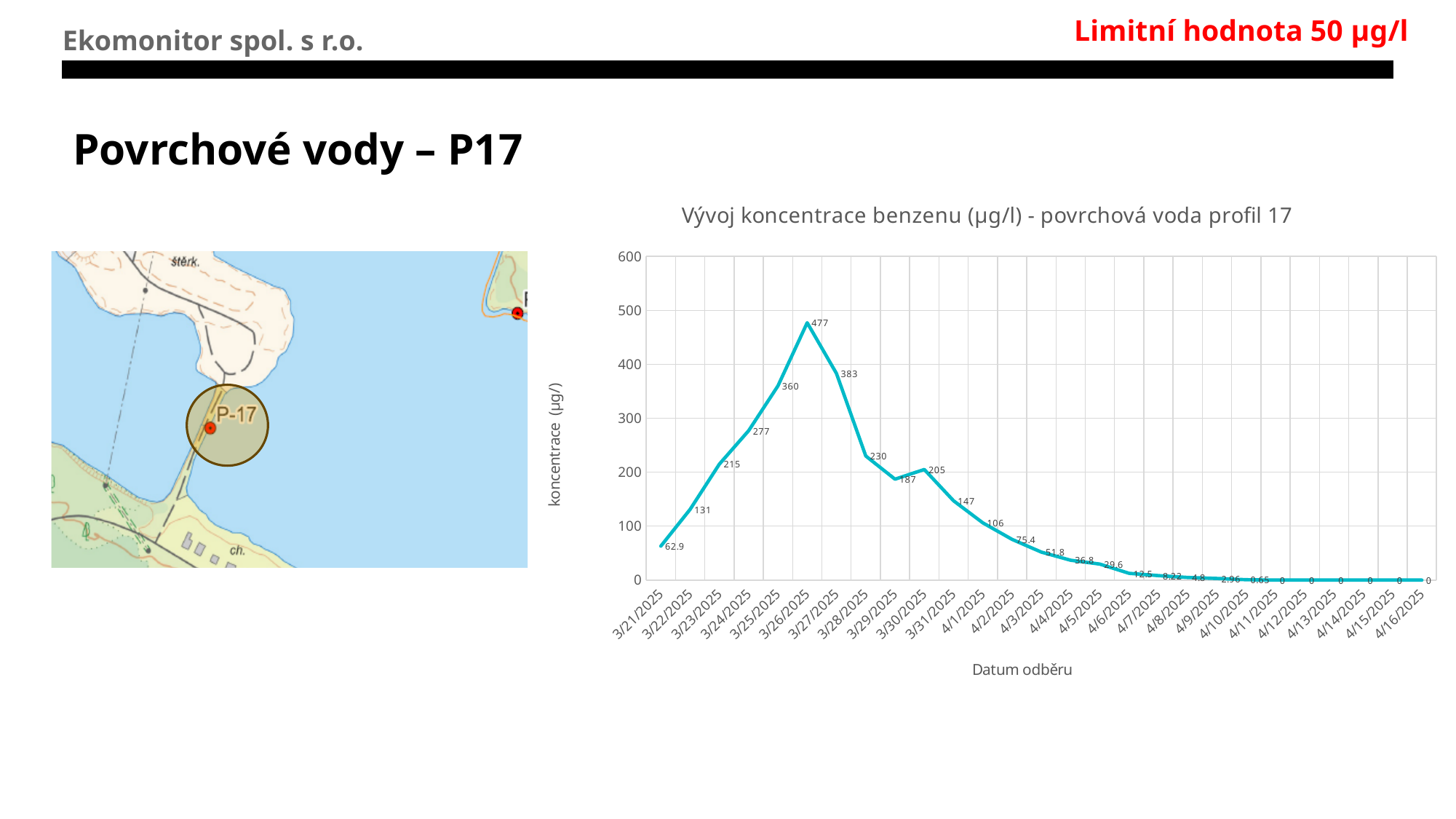
What is the title of the chart? Vývoj koncentrace benzenu (µg/l) - povrchová voda profil 17 What is the value plotted for 4/3/2025? 51.8 What is the benzene concentration on 3/21/2025? 62.9 Does the concentration rise or fall between 3/27/2025 and 4/10/2025? fall On which date is the benzene concentration highest? 3/26/2025 What type of chart is shown on the slide? line chart How many dates are shown on the x axis? 27 Is the value for 3/25/2025 greater or less than 300? greater What is the difference between the values on 3/26/2025 and 3/27/2025? 94 What is the label of the x axis? Datum odběru Which is larger, the value on 3/29/2025 or the value on 3/30/2025? 3/30/2025 What is the benzene concentration on 3/26/2025? 477